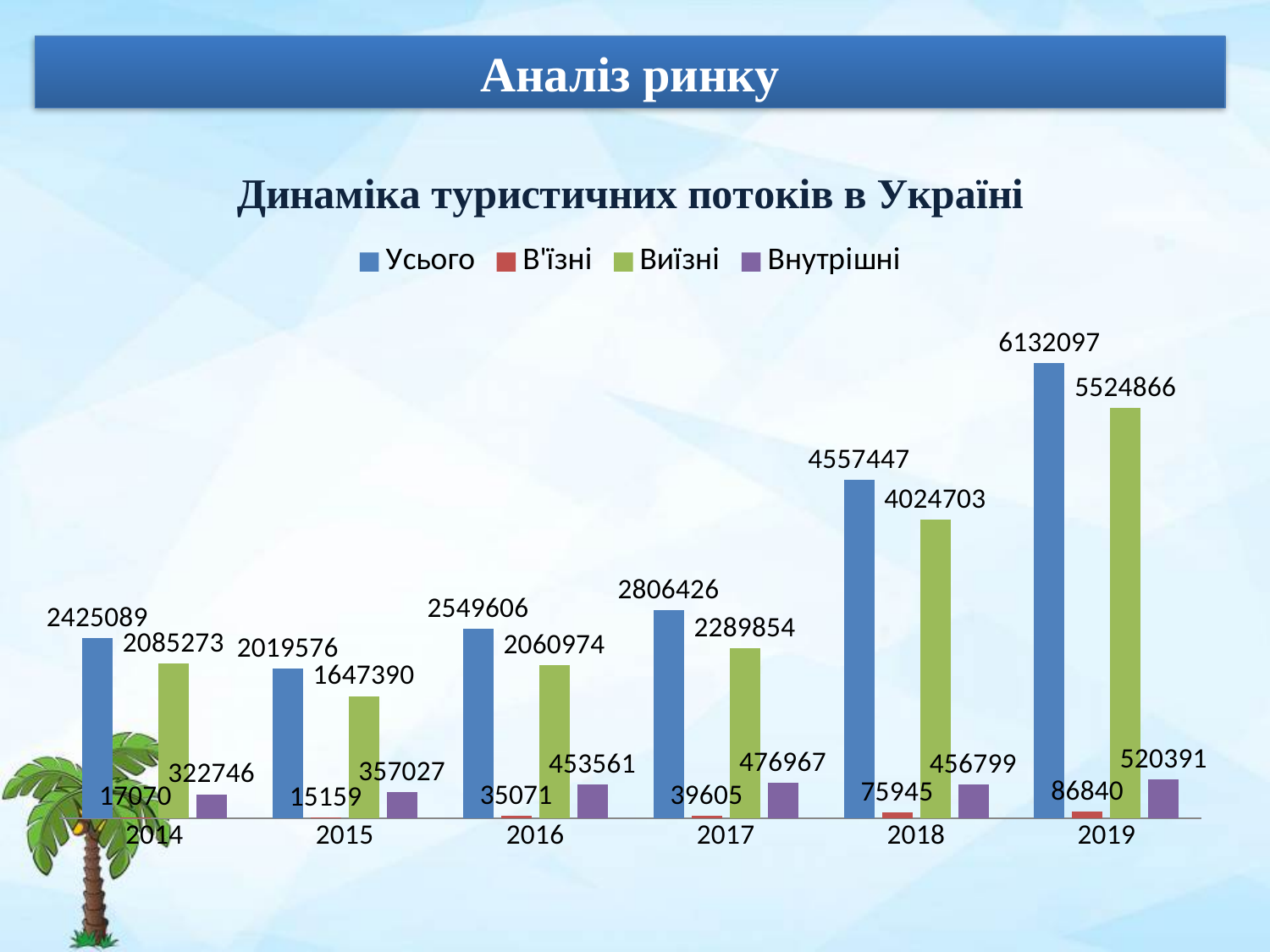
Which is larger: Виїзні in 2016 or Виїзні in 2017? Виїзні in 2017 What is the value of Усього for 2019? 6132097 In which year is the Усього value lowest? 2015 What is the value of Внутрішні for 2018? 456799 What is the value of В'їзні for 2015? 15159 Do the Виїзні values rise or fall from 2015 to 2019? Rise What is the difference between the Усього values for 2019 and 2018? 1574650 What type of chart is shown on the slide? Bar chart How many years are shown on the x axis? 6 How many series does the legend list? 4 In which year is the Усього value highest? 2019 What is the value of Виїзні for 2017? 2289854